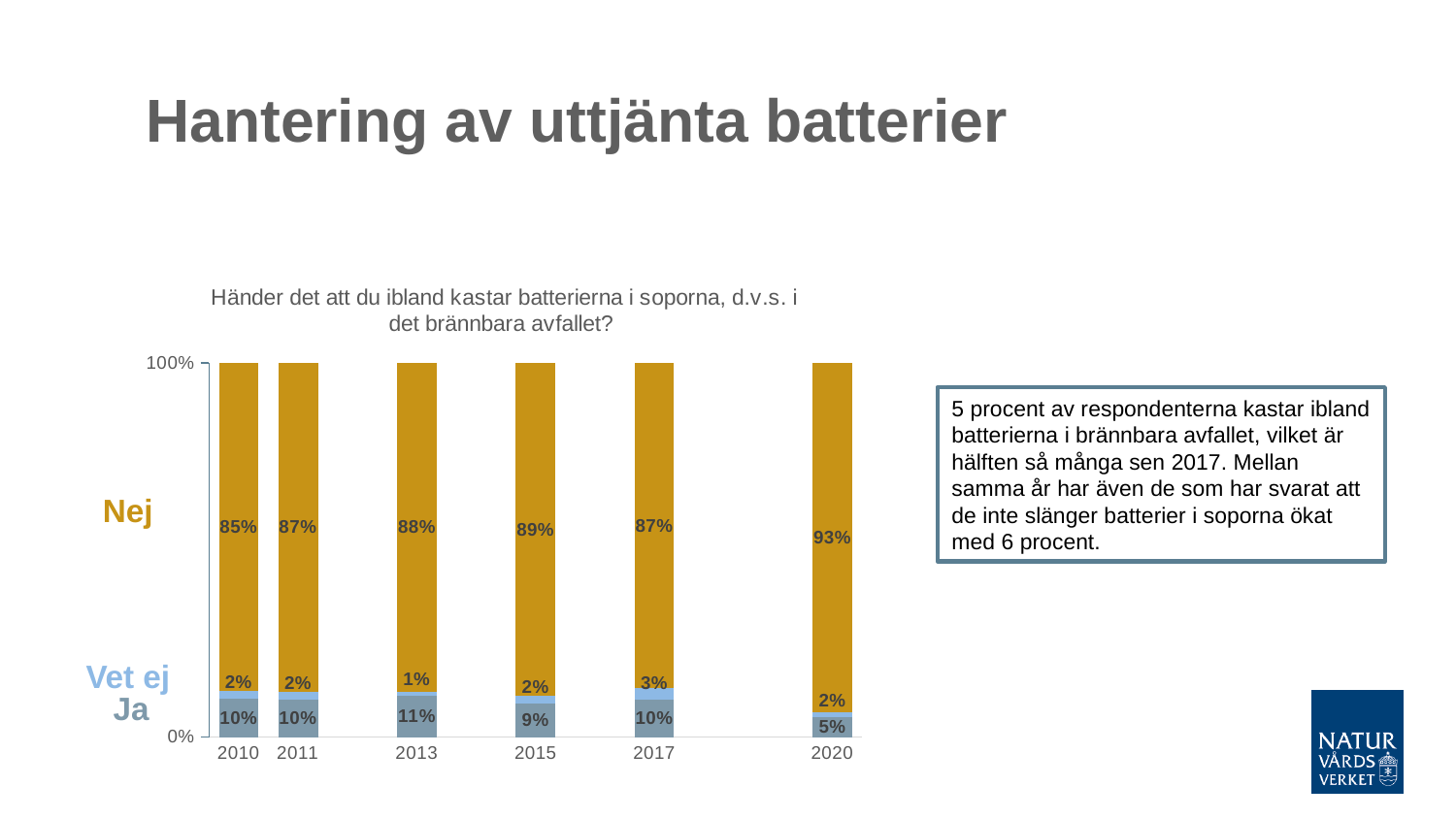
Which is larger, the "Nej" share in 2010 or in 2015? 2015 What is the total of the stacked bar for 2015? 100% What percentage answered "Vet ej" in 2017? 3% In which year is the "Nej" share highest? 2020 In which year is the "Ja" share lowest? 2020 What is the difference between the "Ja" share in 2017 and in 2020? 5% What percentage answered "Ja" in 2013? 11% What percentage answered "Nej" in 2020? 93% What kind of chart is shown on the slide? Stacked bar chart Does the "Nej" share rise or fall from 2017 to 2020? Rise How many series does the chart show? 3 How many years are shown on the x axis? 6